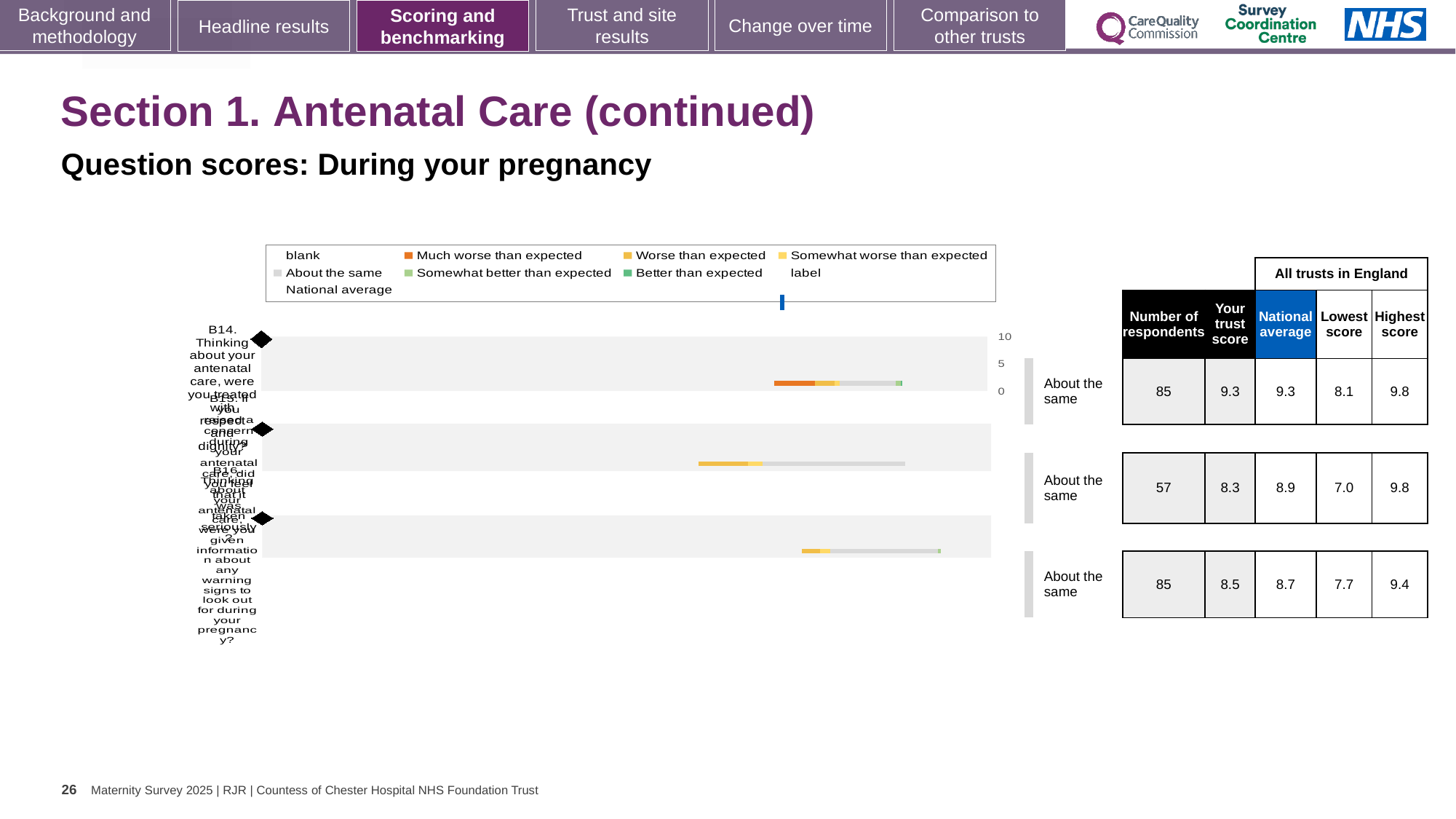
What is the trust score for the second row? 8.3 Which row has the highest trust score? The top row (B14), 9.3 What is the trust score for the top row (B14, treated with respect and dignity)? 9.3 What is the difference between the national average (8.7) and the trust score (8.5) for the bottom row? 0.2 For the second row, which is larger: the trust score or the national average? National average What is the national average for the top row (B14)? 9.3 How many question rows (bars) are plotted in the chart? 3 What benchmark category is shown for all three rows? About the same Which row has the lowest 'Lowest score' value? The second row, 7.0 What is the highest score across all trusts in England for the third (bottom) row? 9.4 How many respondents are listed for the second row? 57 What kind of chart is shown on the slide? bar chart